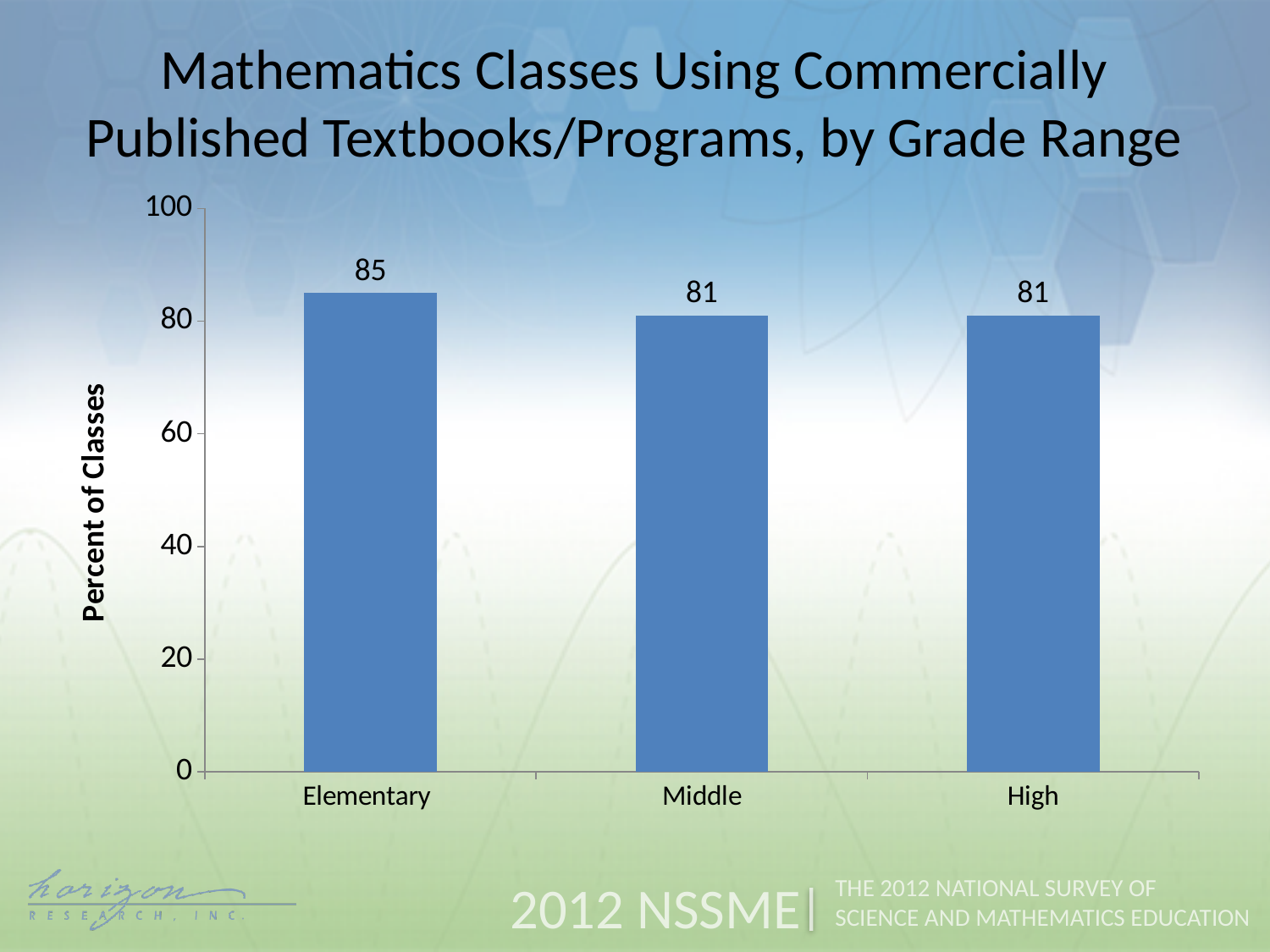
What kind of chart is shown on the slide? bar chart Do the values rise or fall from Elementary to Middle? fall What is the value for High? 81 What is the label on the vertical axis? Percent of Classes Which grade range has the highest percent of classes? Elementary Is the value for Middle greater or less than 60? greater How many grade ranges are shown on the chart? 3 Which is larger, the value for Elementary or the value for High? Elementary What percent of elementary mathematics classes use commercially published textbooks/programs? 85 What is the title of the chart? Mathematics Classes Using Commercially Published Textbooks/Programs, by Grade Range What is the value for Middle? 81 What is the difference between the values for Elementary and Middle? 4